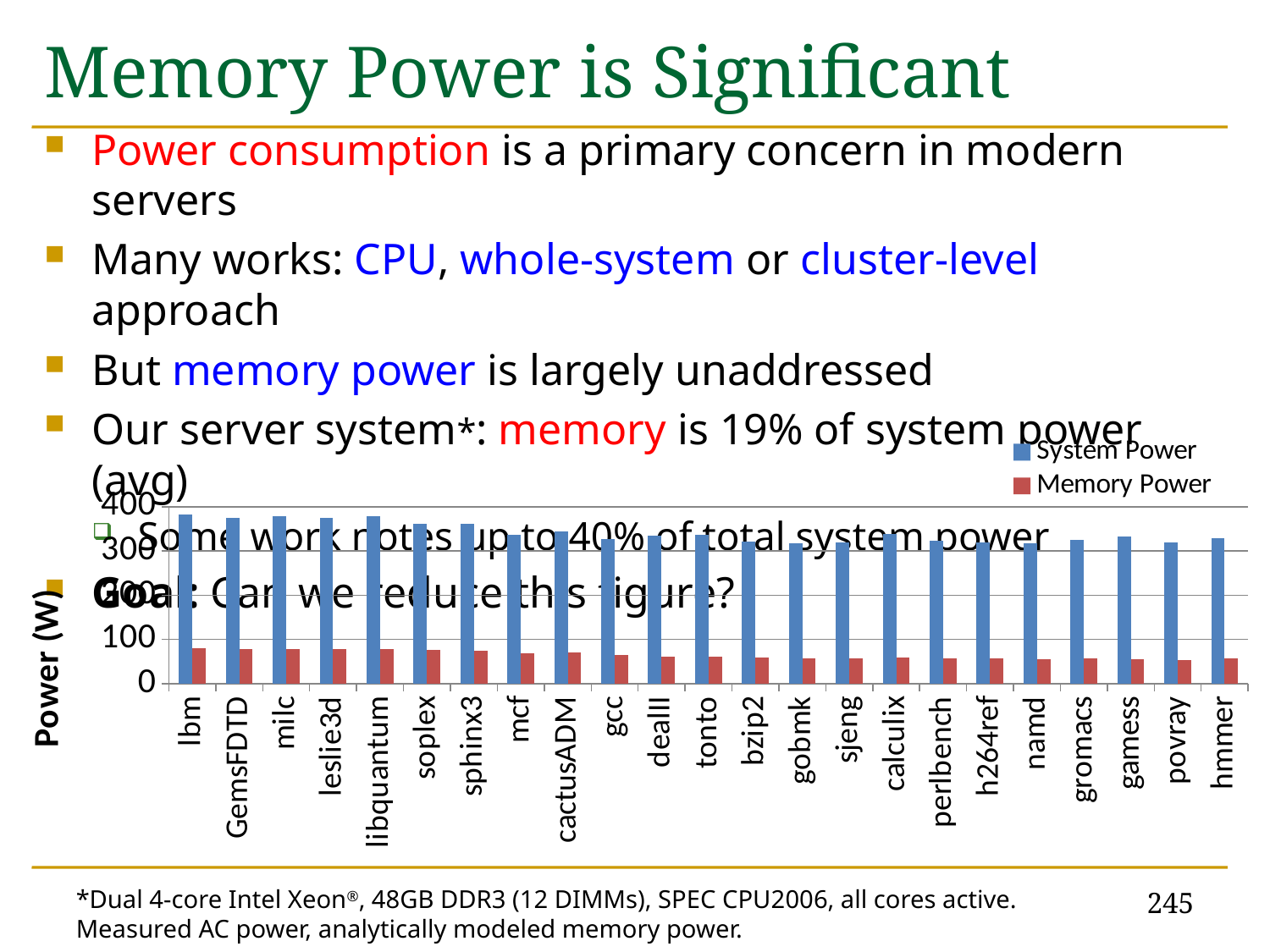
Does the Memory Power series generally rise or fall from left to right across the benchmarks? fall What kind of chart is shown on the slide? bar chart How many benchmark categories are plotted along the x axis? 23 Is the Memory Power value for povray greater or less than 100? less Is the System Power value for hmmer greater or less than 300? greater What is the label on the vertical axis of the chart? Power (W) Which has the larger Memory Power value, lbm or povray? lbm How many series does the chart legend list? 2 Is the Memory Power value for lbm greater or less than 100? less Which series is drawn in red in the chart? Memory Power Which has the larger System Power value, lbm or gobmk? lbm